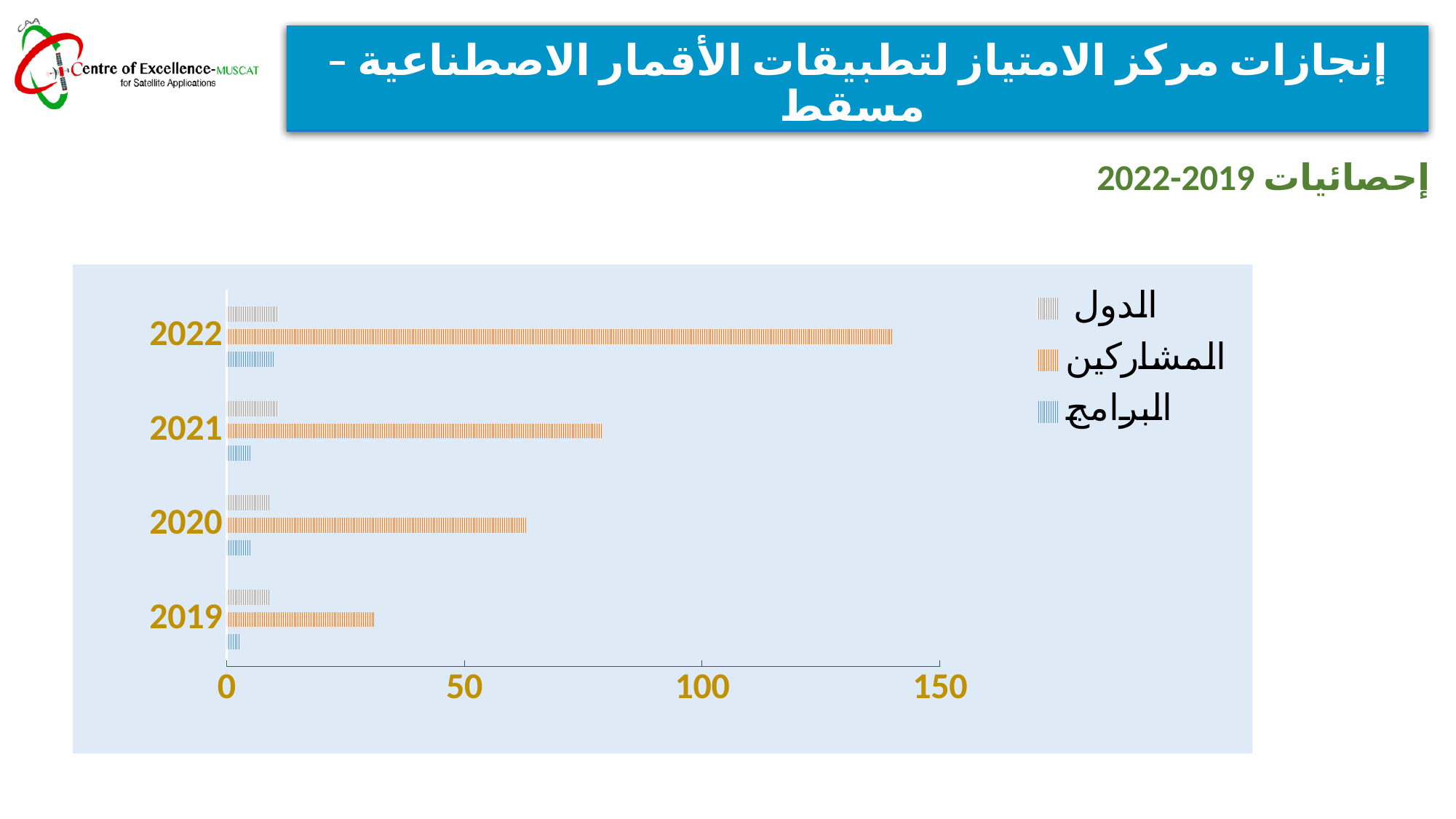
How many series does the chart legend list? 3 Is the value for المشاركين in 2019 greater or less than 50? less Is the value for المشاركين in 2021 greater or less than 100? less What kind of chart is shown on the slide? bar chart Which is larger: the value for المشاركين in 2021 or in 2020? 2021 Which year has the highest value for المشاركين? 2022 How many years (categories) are shown on the chart? 4 Is the value for المشاركين in 2022 greater or less than 100? greater Which year has the lowest value for المشاركين? 2019 Do the values for المشاركين rise or fall from 2019 to 2022? rise Which is larger: the value for البرامج in 2022 or in 2019? 2022 Which series is shown in orange in the legend? المشاركين